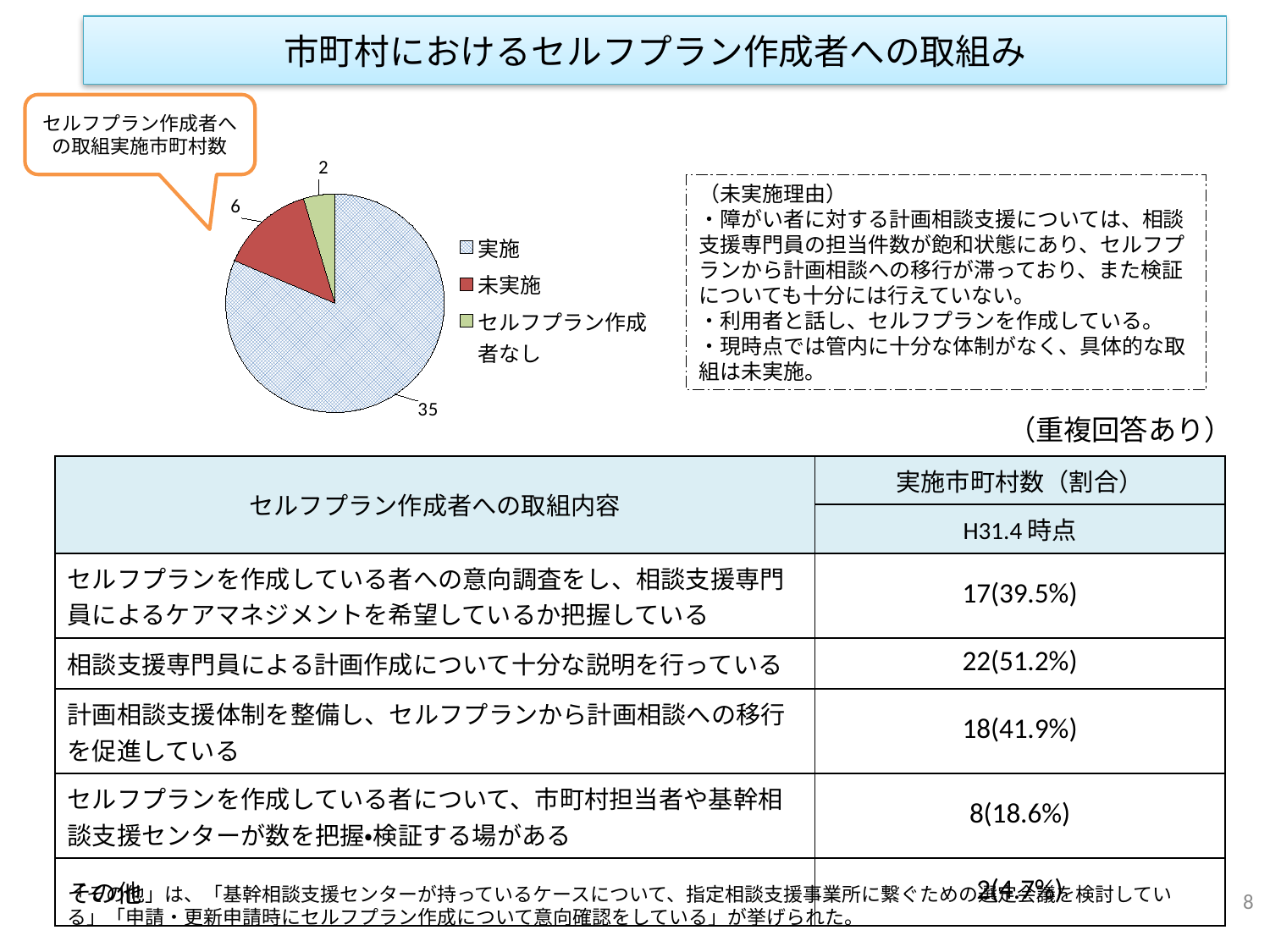
What is the total of all slices in the pie chart? 43 What is the difference between the values for 実施 and 未実施 in the pie chart? 29 What is the value for 未実施 in the pie chart? 6 What does the callout label above the pie chart say the chart shows? セルフプラン作成者への取組実施市町村数 How many entries does the legend of the pie chart list? 3 What is the value for セルフプラン作成者なし in the pie chart? 2 What is the value for 実施 in the pie chart? 35 Which category has the largest slice in the pie chart? 実施 Which category has the smallest slice in the pie chart? セルフプラン作成者なし What kind of chart is shown on the slide? pie chart Which is larger in the pie chart, 未実施 or セルフプラン作成者なし? 未実施 How many slices does the pie chart have? 3